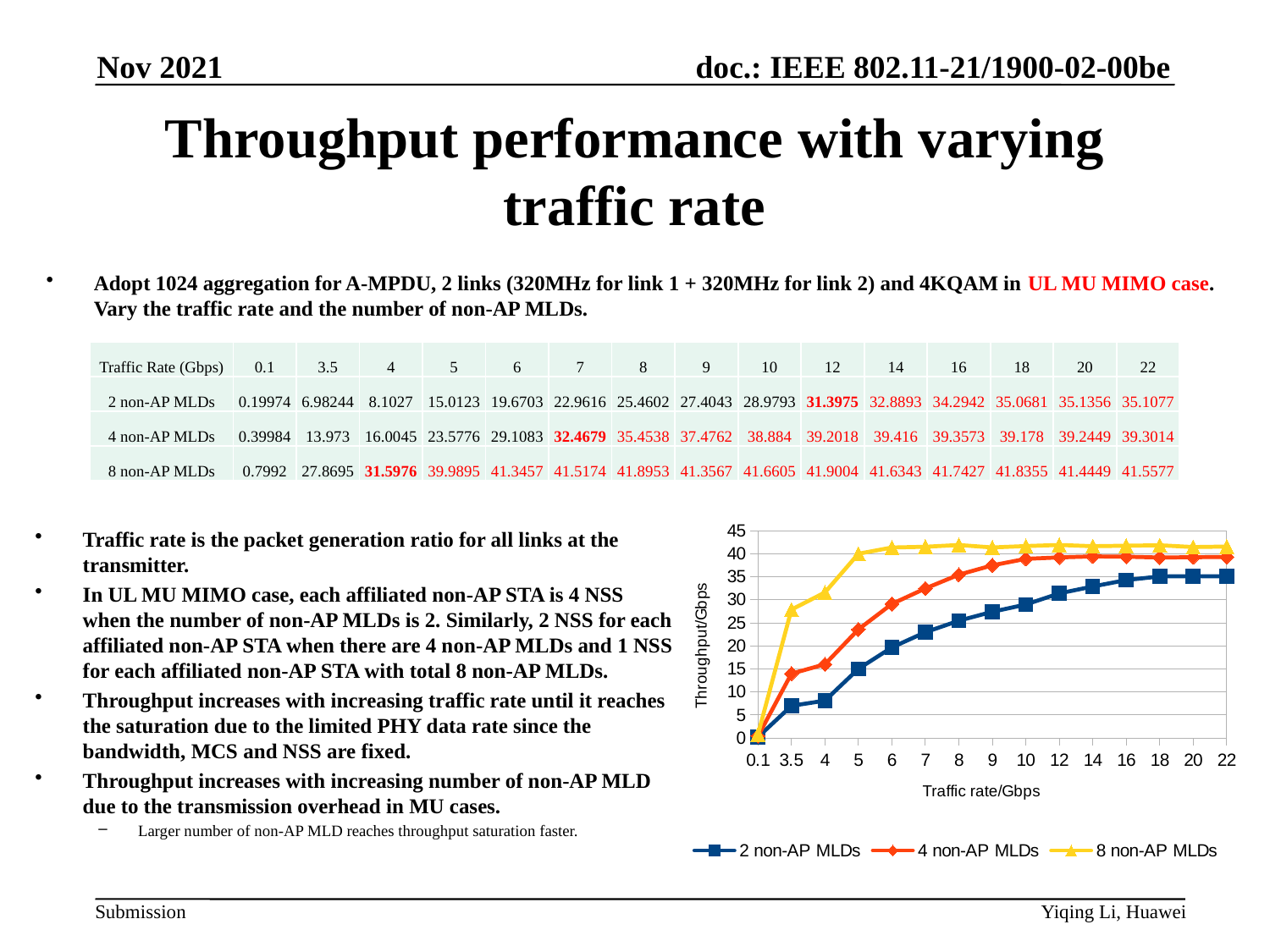
How many series does the chart legend list? 3 What is the throughput for 2 non-AP MLDs at a traffic rate of 22 Gbps? 35.1077 How many traffic rate points are plotted along the x axis of the chart? 15 What is the difference in throughput between 8 non-AP MLDs and 2 non-AP MLDs at a traffic rate of 22 Gbps? 6.45 What is the throughput for 8 non-AP MLDs at a traffic rate of 4 Gbps? 31.5976 At a traffic rate of 10 Gbps, which has the larger throughput: 4 non-AP MLDs or 2 non-AP MLDs? 4 non-AP MLDs What type of chart is shown on the slide? line chart What is the label of the chart's y axis? Throughput/Gbps Is the throughput for 2 non-AP MLDs at a traffic rate of 3.5 Gbps greater or less than 10? less Is the throughput for 8 non-AP MLDs at a traffic rate of 6 Gbps greater or less than 40? greater Which series has the highest throughput at a traffic rate of 5 Gbps? 8 non-AP MLDs Does the throughput for 2 non-AP MLDs generally rise or fall as the traffic rate increases along the x axis? rise